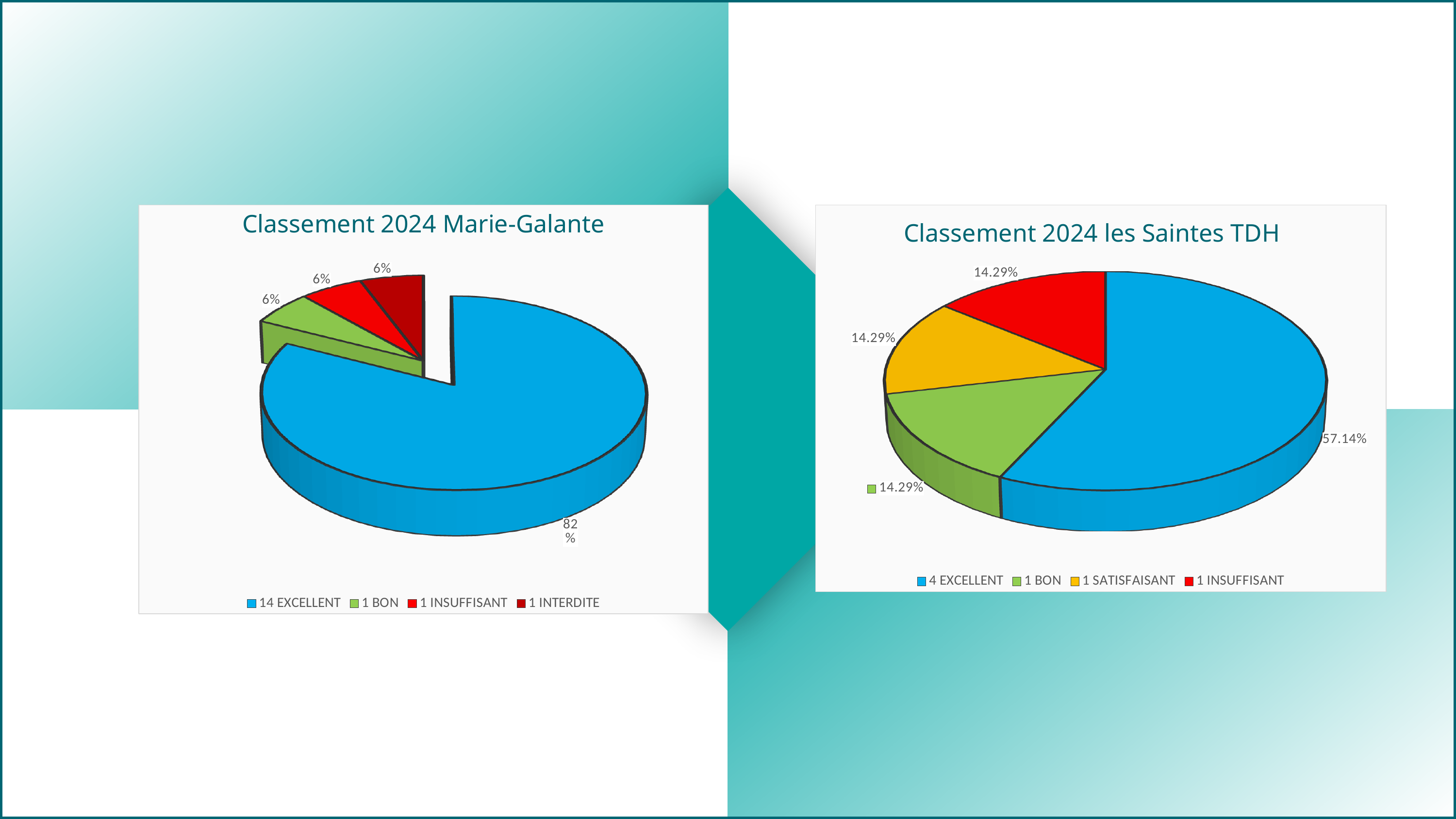
In the "Classement 2024 les Saintes TDH" chart, what share of the pie does the 1 SATISFAISANT slice represent? 14.29% What type of chart is "Classement 2024 Marie-Galante"? Pie chart In the "Classement 2024 Marie-Galante" chart, what share of the pie does the 14 EXCELLENT slice represent? 82% In the "Classement 2024 les Saintes TDH" chart, is the 4 EXCELLENT slice larger or smaller than the 1 BON slice? Larger In the "Classement 2024 les Saintes TDH" chart, which category has the largest slice? 4 EXCELLENT In the "Classement 2024 Marie-Galante" chart, which category has the largest slice? 14 EXCELLENT How many slices does the "Classement 2024 Marie-Galante" pie chart have? 4 In the "Classement 2024 les Saintes TDH" chart, what share of the pie does the 4 EXCELLENT slice represent? 57.14% In the "Classement 2024 les Saintes TDH" chart, what colour is the 1 SATISFAISANT slice? Yellow In the "Classement 2024 Marie-Galante" chart, what is the difference between the 14 EXCELLENT share and the 1 INTERDITE share? 76% How many categories does the legend of the "Classement 2024 les Saintes TDH" chart list? 4